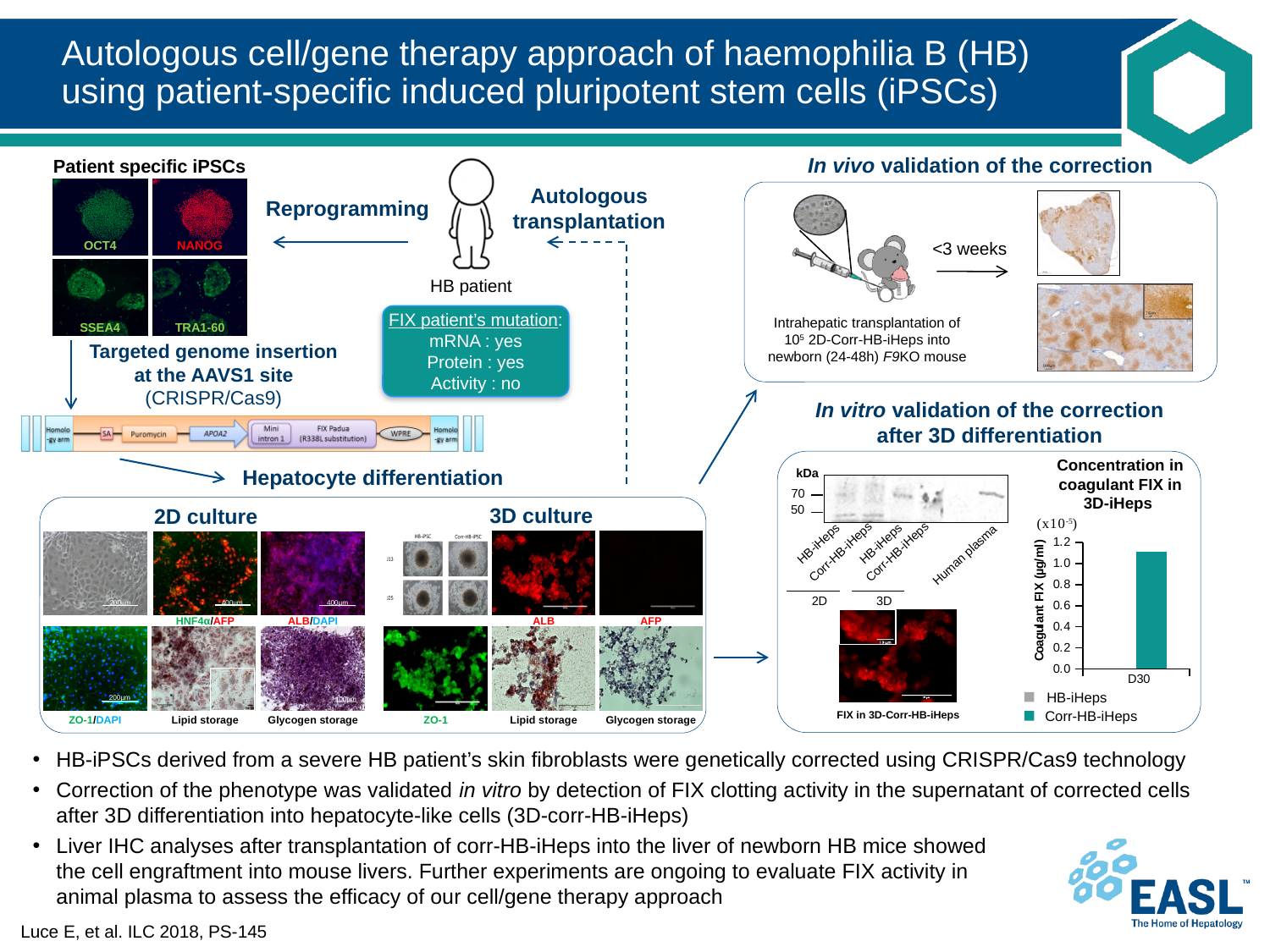
What is the only category label on the x axis of the 'Concentration in coagulant FIX in 3D-iHeps' chart? D30 In the 'Concentration in coagulant FIX in 3D-iHeps' chart, which series has the highest bar? Corr-HB-iHeps What is the y-axis label of the 'Concentration in coagulant FIX in 3D-iHeps' chart? Coagulant FIX (µg/ml) In the 'Concentration in coagulant FIX in 3D-iHeps' chart, is the value for Corr-HB-iHeps at D30 greater or less than 1.2? less How many categories are shown on the x axis of the 'Concentration in coagulant FIX in 3D-iHeps' chart? 1 In the 'Concentration in coagulant FIX in 3D-iHeps' chart, which series has the larger value at D30, HB-iHeps or Corr-HB-iHeps? Corr-HB-iHeps How many series does the legend of the 'Concentration in coagulant FIX in 3D-iHeps' chart list? 2 What kind of chart is the 'Concentration in coagulant FIX in 3D-iHeps' chart? bar chart In the 'Concentration in coagulant FIX in 3D-iHeps' chart, is the value for Corr-HB-iHeps at D30 greater or less than 1.0? greater In the 'Concentration in coagulant FIX in 3D-iHeps' chart, is the value for Corr-HB-iHeps at D30 greater or less than 0.8? greater